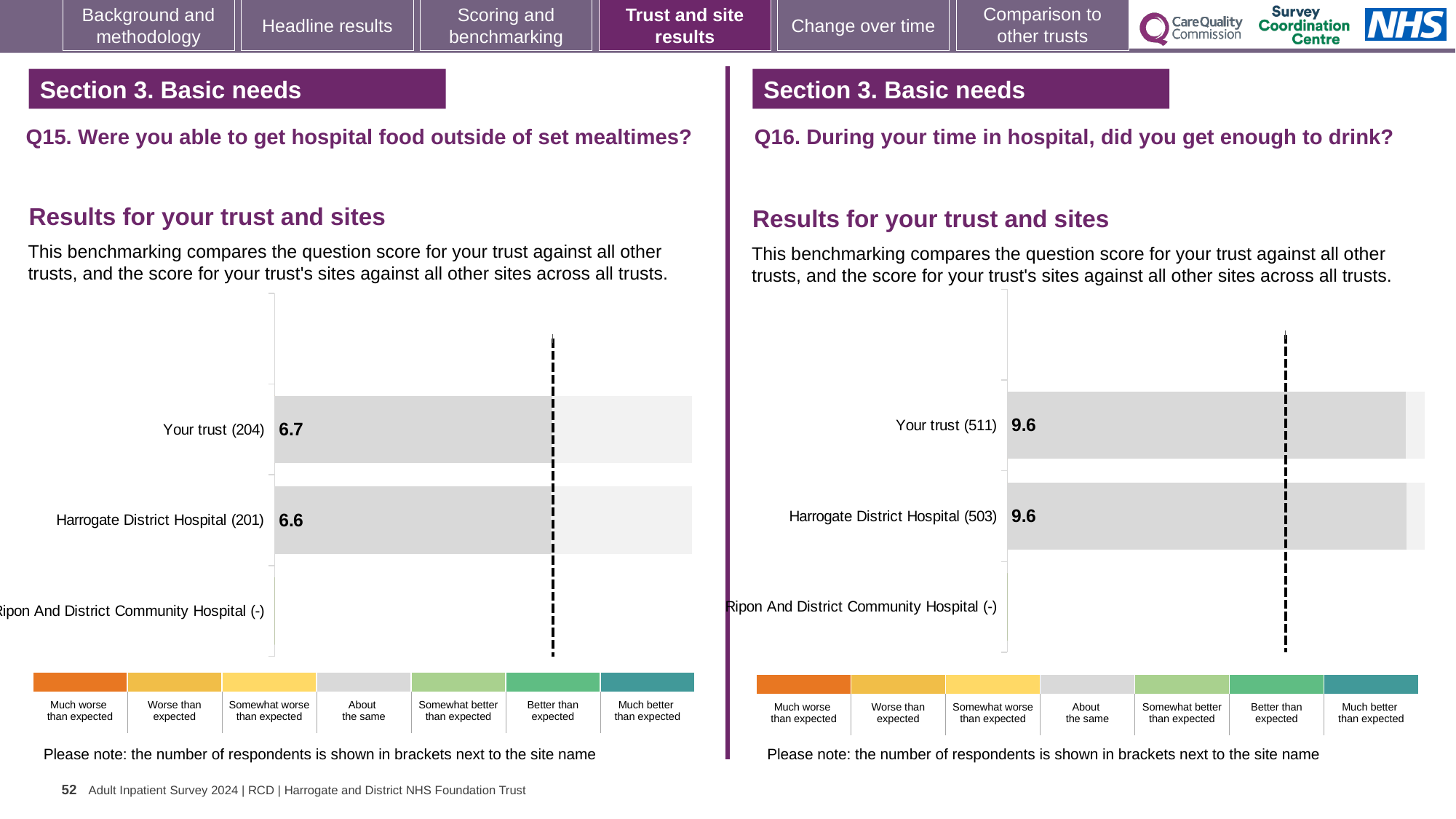
What kind of chart is the Q15 chart (left)? Bar chart On the Q15 chart (left), which has the higher score, Your trust or Harrogate District Hospital? Your trust How many categories are listed on the Q16 chart (right)? 3 What is the question title of the chart on the right side of the slide? Q16. During your time in hospital, did you get enough to drink? On the Q16 chart (right), what is the score for Harrogate District Hospital? 9.6 On the Q15 chart (left), how many respondents are shown in brackets for Your trust? 204 On the Q15 chart (left), what is the score for Harrogate District Hospital? 6.6 On the Q16 chart (right), how many respondents are shown in brackets for Harrogate District Hospital? 503 On the Q15 chart (left), what is the difference between the score for Your trust and the score for Harrogate District Hospital? 0.1 On the Q15 chart (left), what is the score for Your trust? 6.7 On the Q16 chart (right), what value is shown for Ripon And District Community Hospital? - On the Q16 chart (right), what is the score for Your trust? 9.6